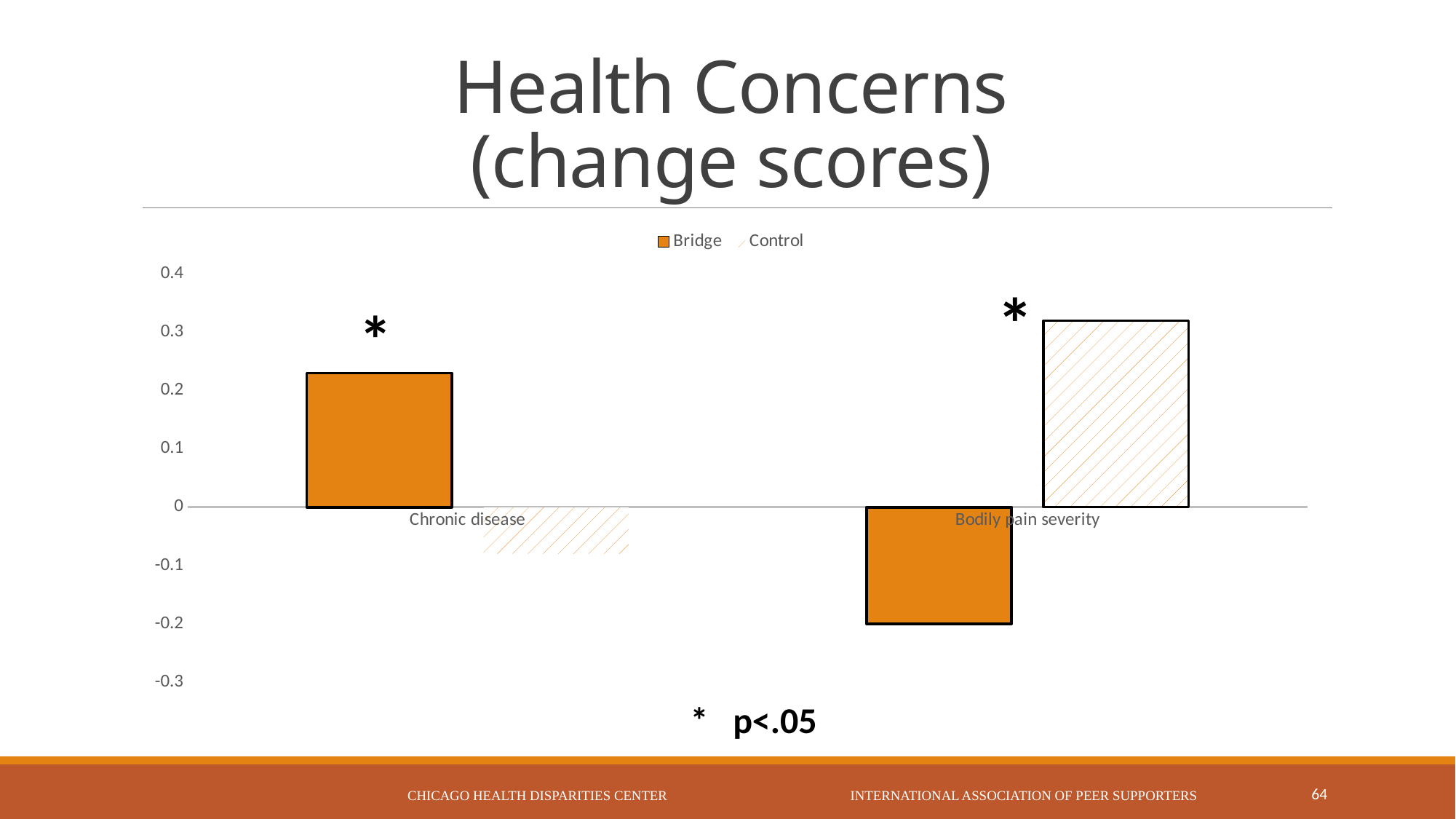
What kind of chart is shown on the slide? bar chart Is the Control value for Chronic disease greater or less than -0.1? greater Is the Bridge value for Chronic disease greater or less than 0.1? greater How many categories are shown on the x axis of the chart? 2 For Chronic disease, which series has the larger value, Bridge or Control? Bridge Is the Bridge value for Bodily pain severity greater or less than -0.1? less Which series is drawn with a hatched (diagonal line) fill? Control Which two series are listed in the chart's legend? Bridge and Control Which bar in the chart has the lowest value? Bridge, Bodily pain severity For Bodily pain severity, which series has the larger value, Bridge or Control? Control How many series does the chart's legend list? 2